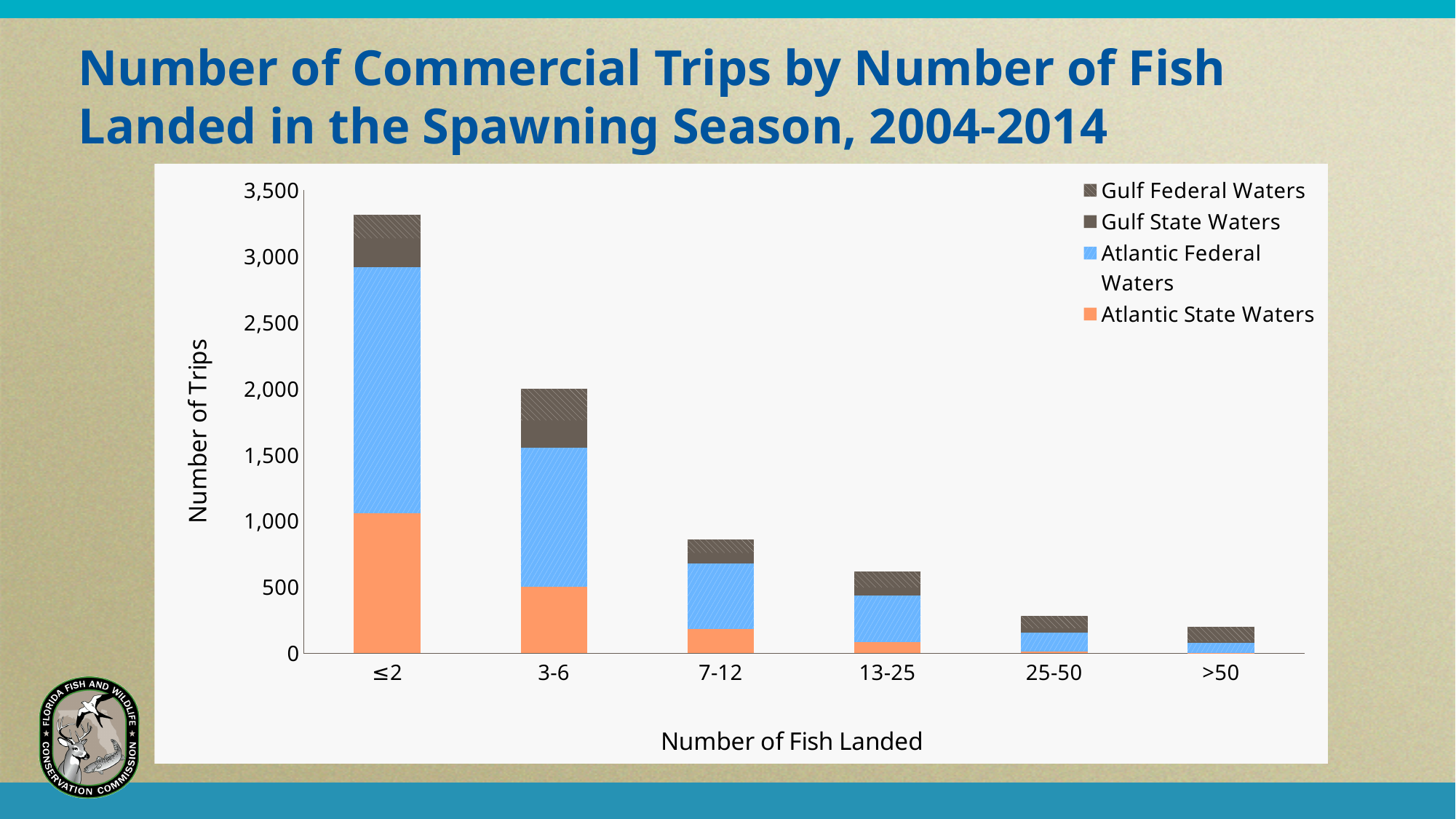
How many series does the chart's legend list? 4 Is the total number of trips for the 3-6 category greater or less than 1,500? greater Is the total number of trips for the ≤2 category greater or less than 3,000? greater Which category has more total trips, 7-12 or 13-25? 7-12 Is the total number of trips for the 7-12 category greater or less than 1,000? less Which number-of-fish-landed category has the lowest total number of trips? >50 How many categories are shown on the x axis of the chart? 6 Do the total number of trips rise or fall as the number of fish landed increases along the x axis? fall Which number-of-fish-landed category has the highest total number of trips? ≤2 What is the label of the y axis of the chart? Number of Trips What kind of chart is shown on the slide? Stacked bar chart